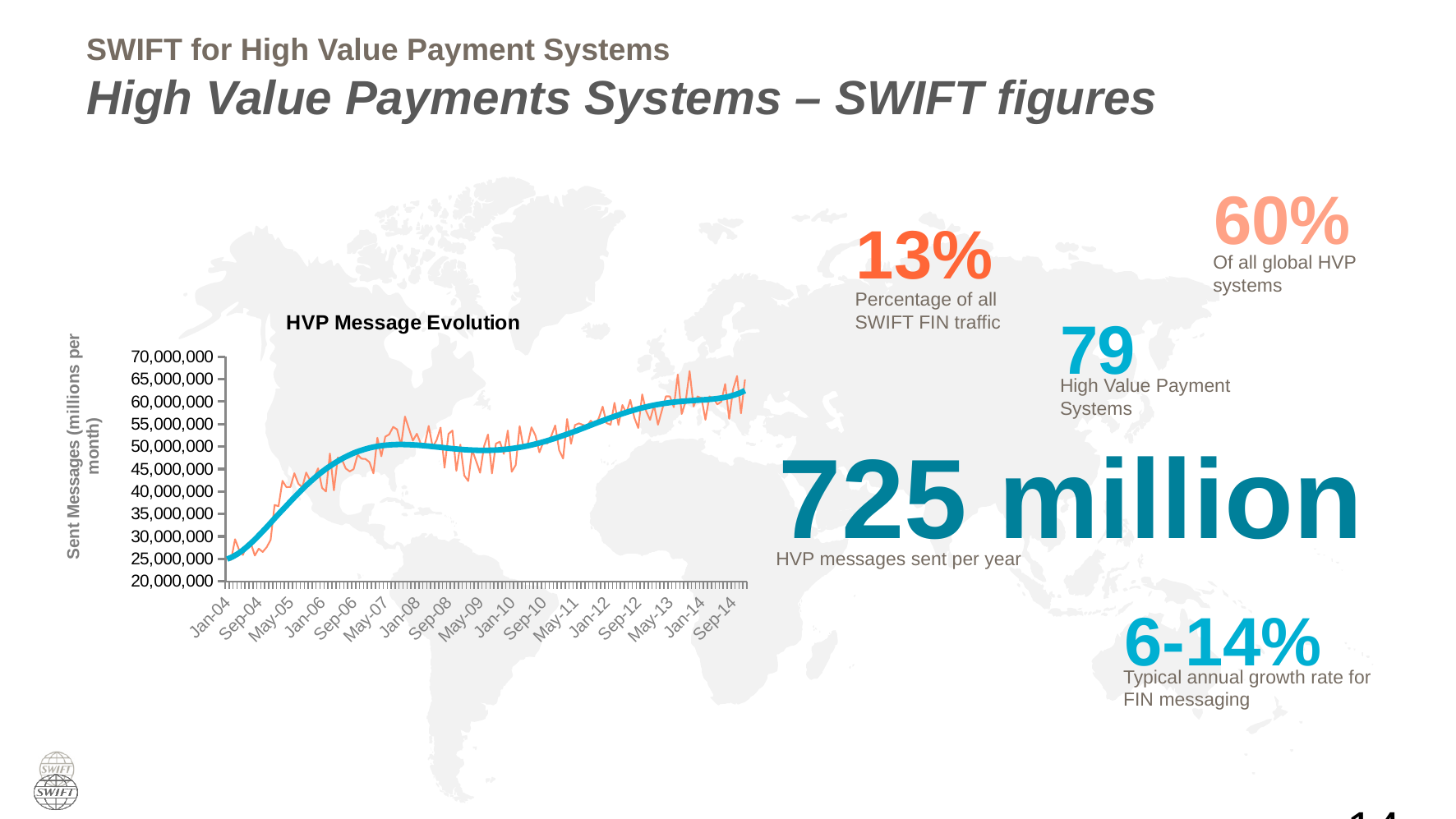
What is the label of the vertical axis of the HVP Message Evolution chart? Sent Messages (millions per month) In the HVP Message Evolution chart, is the value at May-09 greater or less than 55,000,000? less What is the first date label on the horizontal axis of the HVP Message Evolution chart? Jan-04 In the HVP Message Evolution chart, is the value at Jan-04 greater or less than 30,000,000? less Overall, do the values in the HVP Message Evolution chart rise or fall from Jan-04 to Sep-14? rise What is the highest tick value shown on the vertical axis of the HVP Message Evolution chart? 70,000,000 How many lines are plotted in the HVP Message Evolution chart? 2 In the HVP Message Evolution chart, is the value at May-07 greater or less than 40,000,000? greater What kind of chart is the HVP Message Evolution chart? line chart In the HVP Message Evolution chart, is the value at Sep-14 larger or smaller than the value at Jan-04? larger